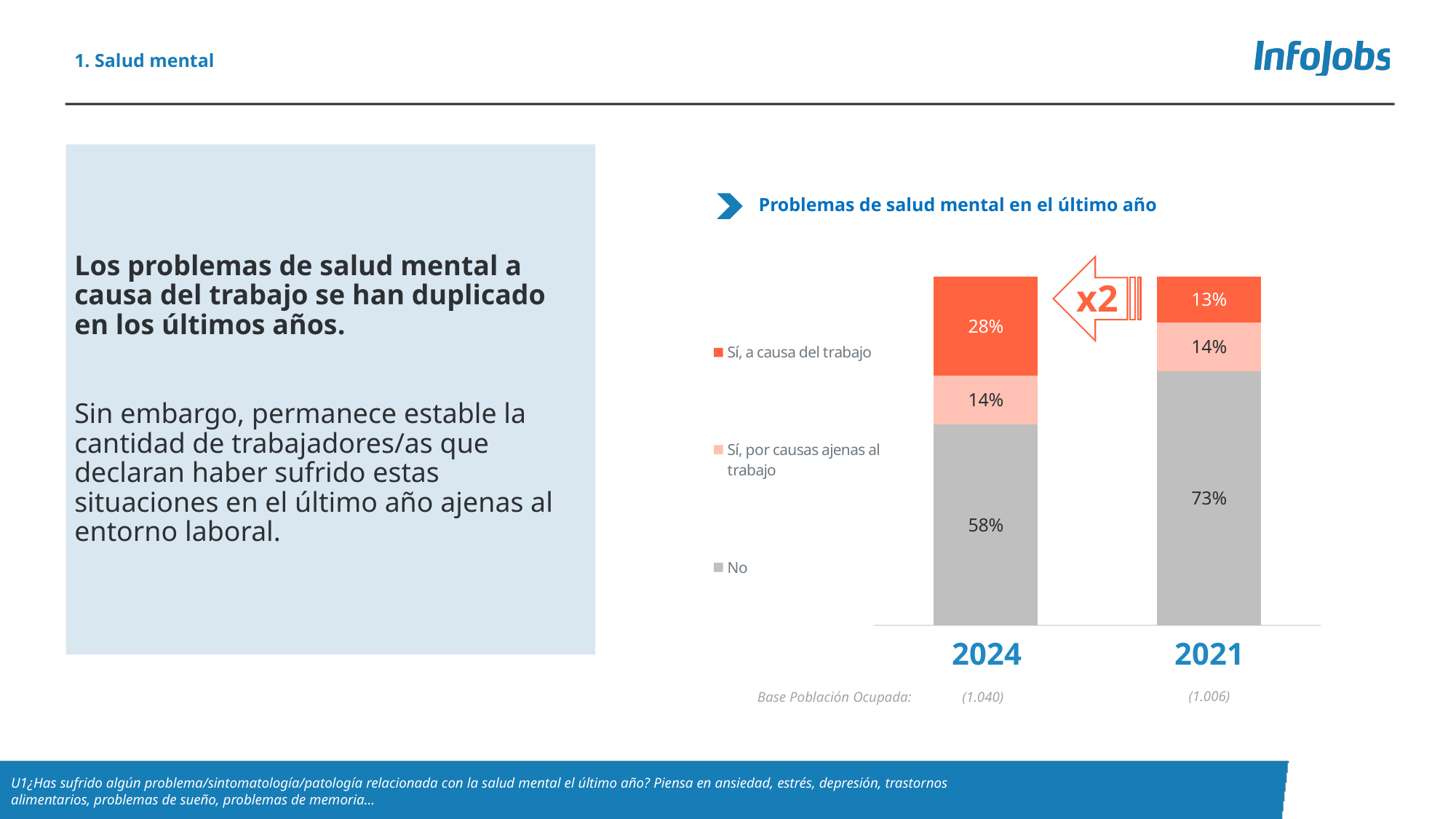
How many series does the legend list? 3 What is the value for "Sí, por causas ajenas al trabajo" in 2021? 14% What is the value for "No" in 2024? 58% What is the difference between the "Sí, a causa del trabajo" values for 2024 and 2021? 15 percentage points Which year has the larger value for "Sí, a causa del trabajo"? 2024 What type of chart is shown on the slide? Stacked bar chart Which year has the larger value for "No", 2024 or 2021? 2021 How many years (categories) are shown on the x axis? 2 What is the value for "No" in 2021? 73% What is the value for "Sí, a causa del trabajo" in 2024? 28% What is the title of the chart? Problemas de salud mental en el último año What is the value for "Sí, a causa del trabajo" in 2021? 13%